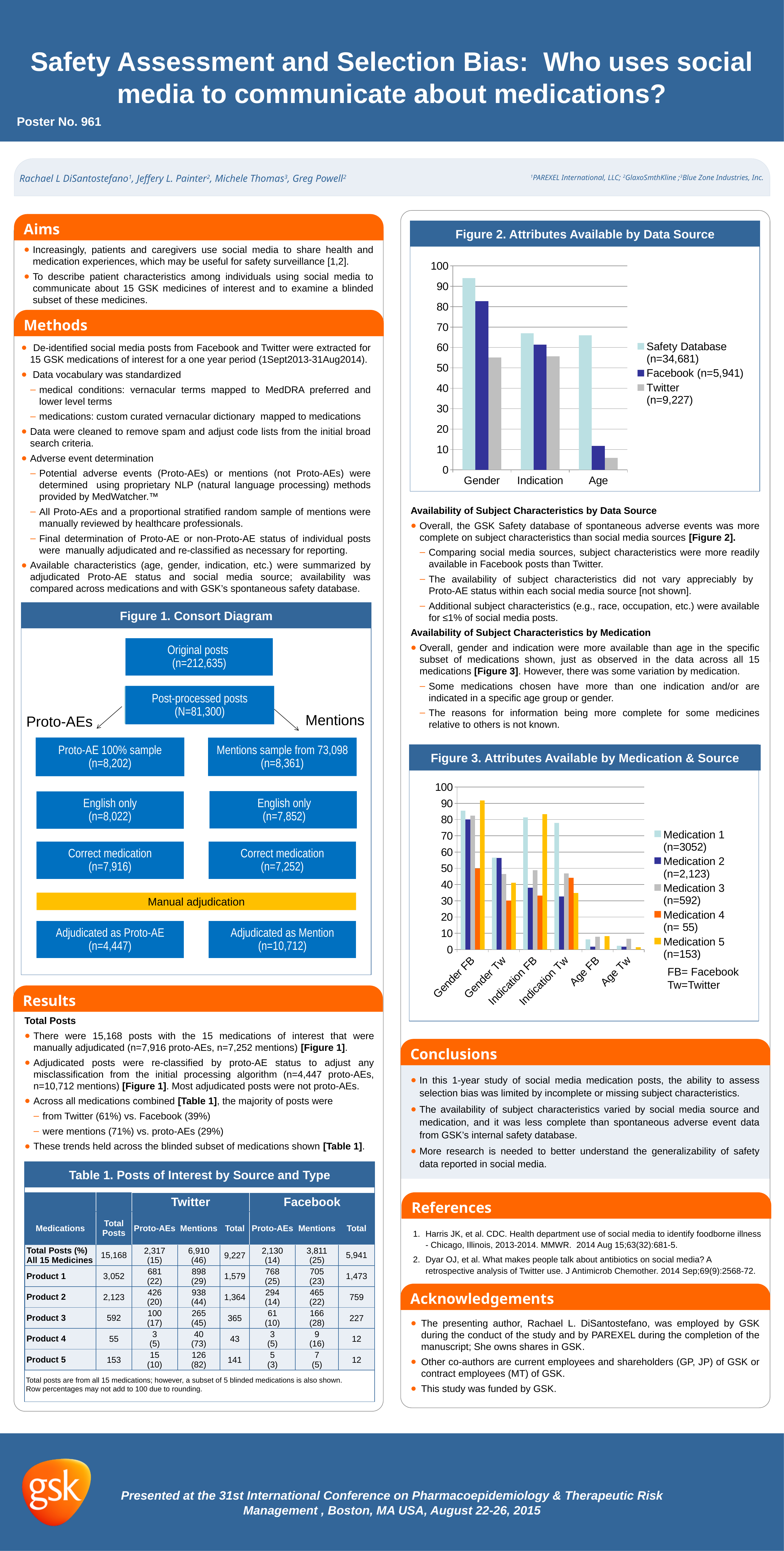
In Figure 2, which series has the lowest value for Age? Twitter (n=9,227) In Figure 3, how many series does the legend list? 5 In Figure 2, how many series does the legend list? 3 In Figure 3, how many categories are shown on the x axis? 6 In Figure 2, is the Twitter value for Age greater or less than 10? less In Figure 2, do the Facebook values rise or fall from Gender to Age along the x axis? fall In Figure 3, is the Medication 1 value for Indication FB greater or less than 70? greater In Figure 2, how many categories are shown on the x axis? 3 In Figure 2, which is larger for Gender: the Facebook value or the Twitter value? Facebook In Figure 3, which medication has the highest value for Gender FB? Medication 5 (n=153) In Figure 2, is the Safety Database value for Gender greater or less than 90? greater What kind of chart is Figure 2? bar chart